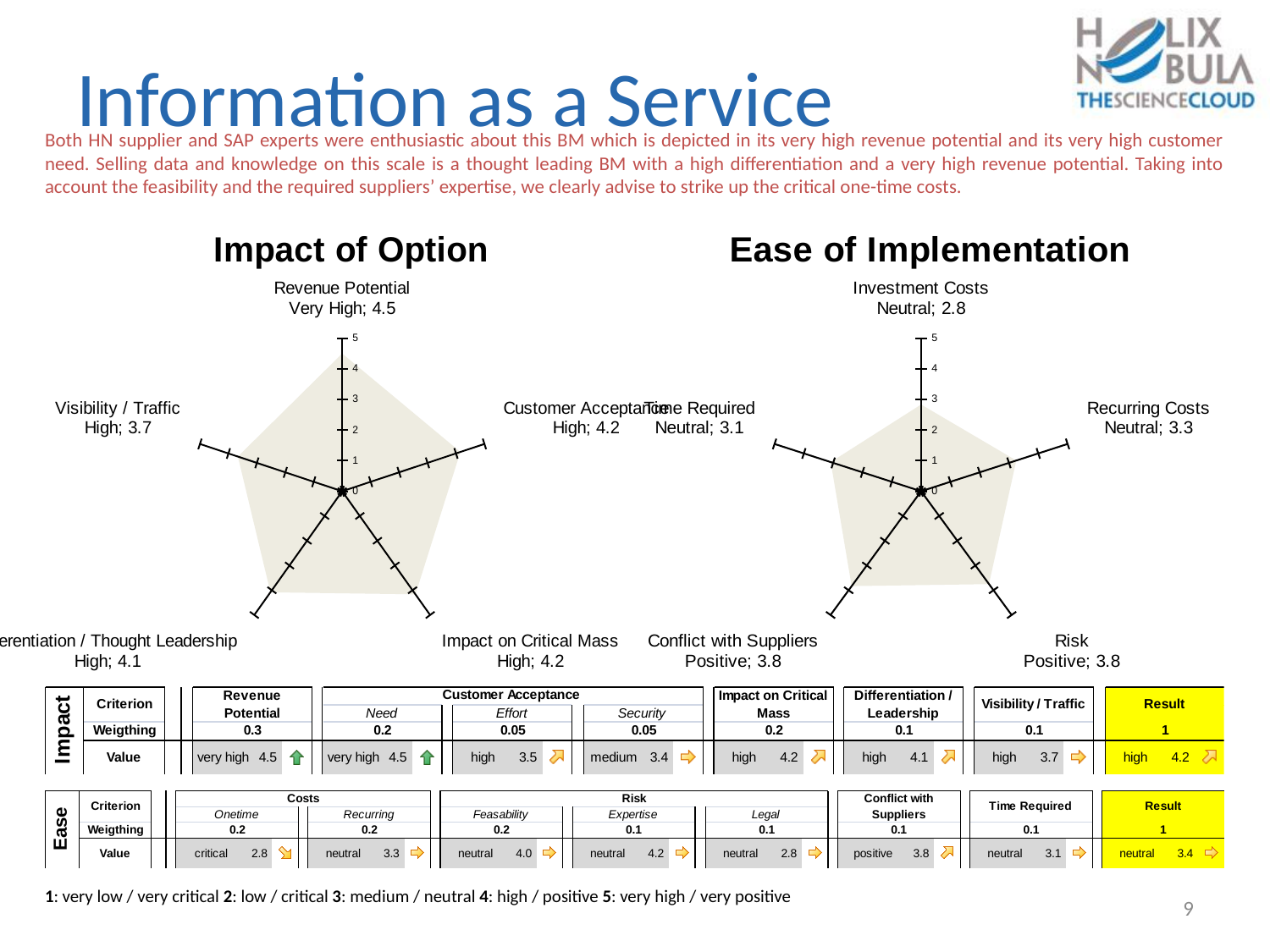
On the Ease of Implementation chart, which criterion has the lowest value? Investment Costs On the Ease of Implementation chart, what is the value for Investment Costs? 2.8 On the Impact of Option chart, what is the value for Visibility / Traffic? 3.7 On the Impact of Option chart, which criterion has the lowest value? Visibility / Traffic How many criteria are plotted on the Ease of Implementation chart? 5 On the Ease of Implementation chart, which is larger, the value for Risk or the value for Time Required? Risk On the Impact of Option chart, what is the difference between the values for Revenue Potential and Visibility / Traffic? 0.8 On the Ease of Implementation chart, is the value for Investment Costs greater or less than 3? less What kind of chart is the Impact of Option chart? Radar chart On the Impact of Option chart, what is the value for Revenue Potential? 4.5 On the Ease of Implementation chart, what is the value for Time Required? 3.1 On the Impact of Option chart, which criterion has the highest value? Revenue Potential